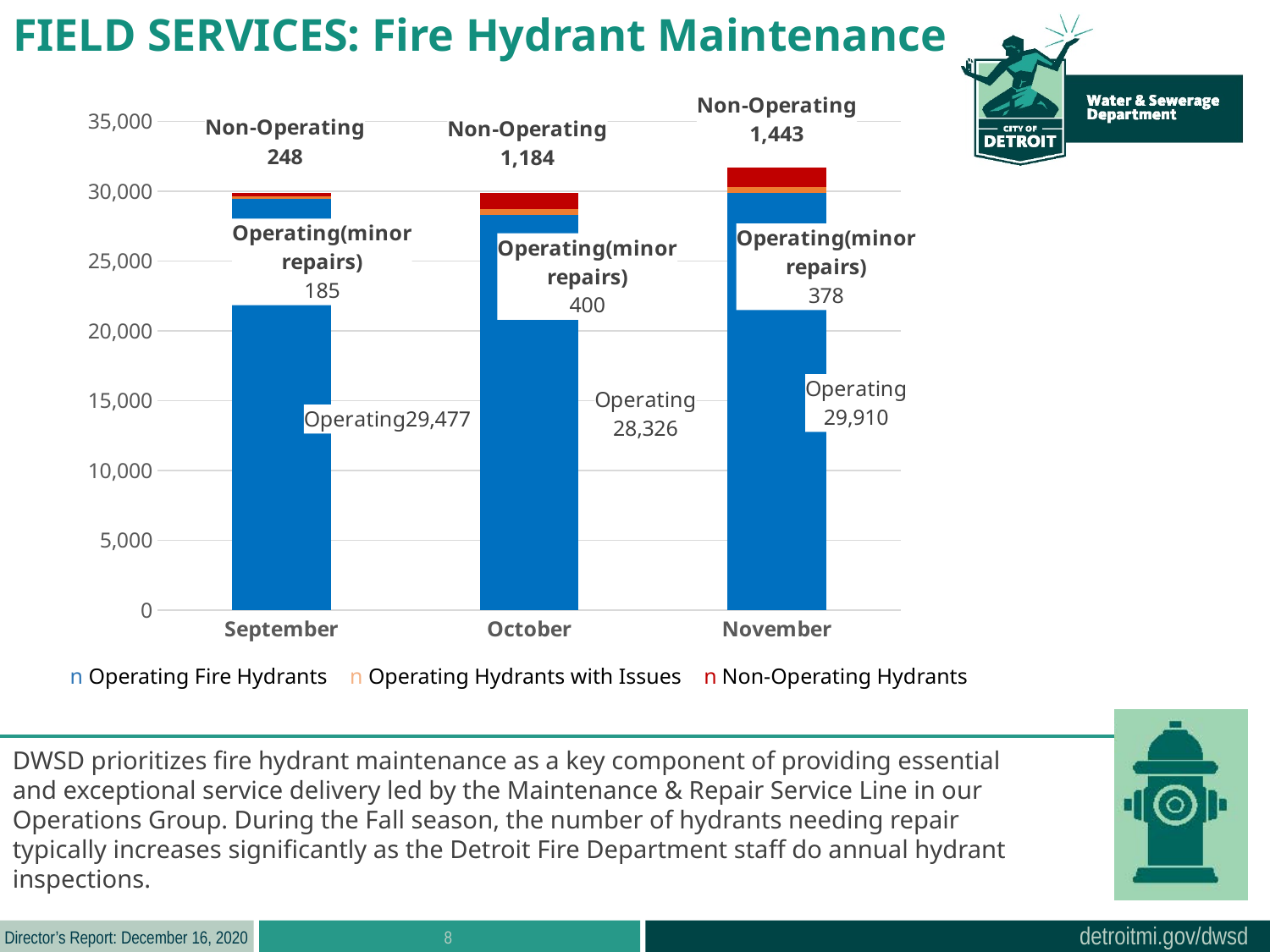
How many months are shown on the x axis of the chart? 3 Which month has the highest Non-Operating value? November Which is larger, the Operating (minor repairs) value for October or for November? October What is the Non-Operating value for November? 1,443 Which month has the lowest Operating value? October What is the number of Operating fire hydrants in October? 28,326 What is the difference between the Non-Operating values for November and September? 1,195 What is the Operating (minor repairs) value for September? 185 Do the Non-Operating values rise or fall from September to November? Rise How many series does the chart legend list? 3 What is the total of the stacked bar for November? 31,731 What type of chart is shown on the slide? Stacked bar chart